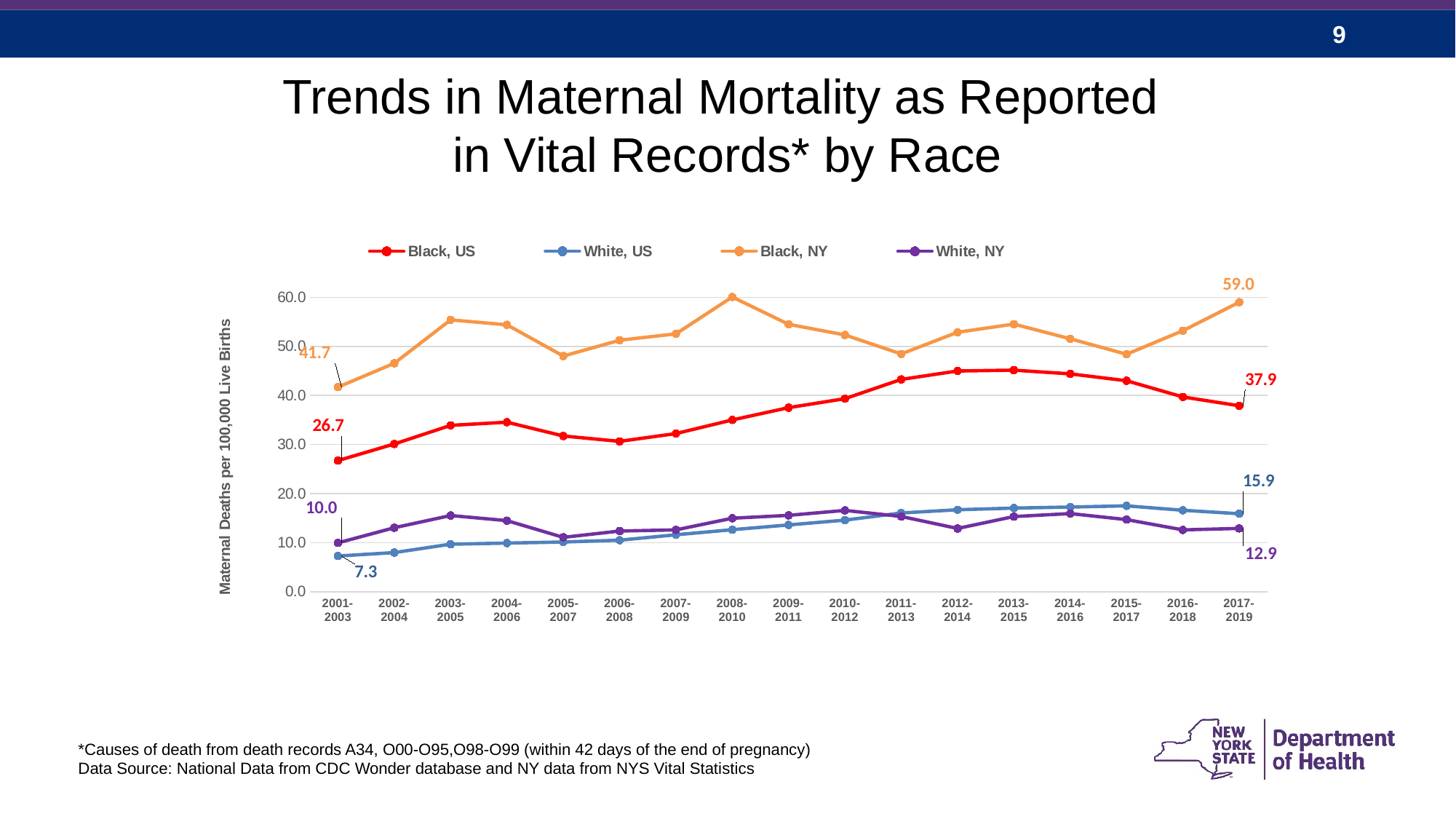
How many series does the legend list? 4 What is the difference between the Black, US and White, US values in 2017-2019? 22.0 What is the value for Black, NY in 2017-2019? 59.0 What is the difference between the Black, NY values in 2017-2019 and 2001-2003? 17.3 What type of chart is shown on the slide? line chart What is the value for Black, US in 2001-2003? 26.7 Is the value for Black, NY in 2008-2010 greater or less than 50.0? greater Which series has the highest value in 2017-2019? Black, NY What is the value for White, NY in 2001-2003? 10.0 Which series has the lowest value in 2001-2003? White, US How many time periods are shown on the x axis? 17 What is the value for White, US in 2017-2019? 15.9